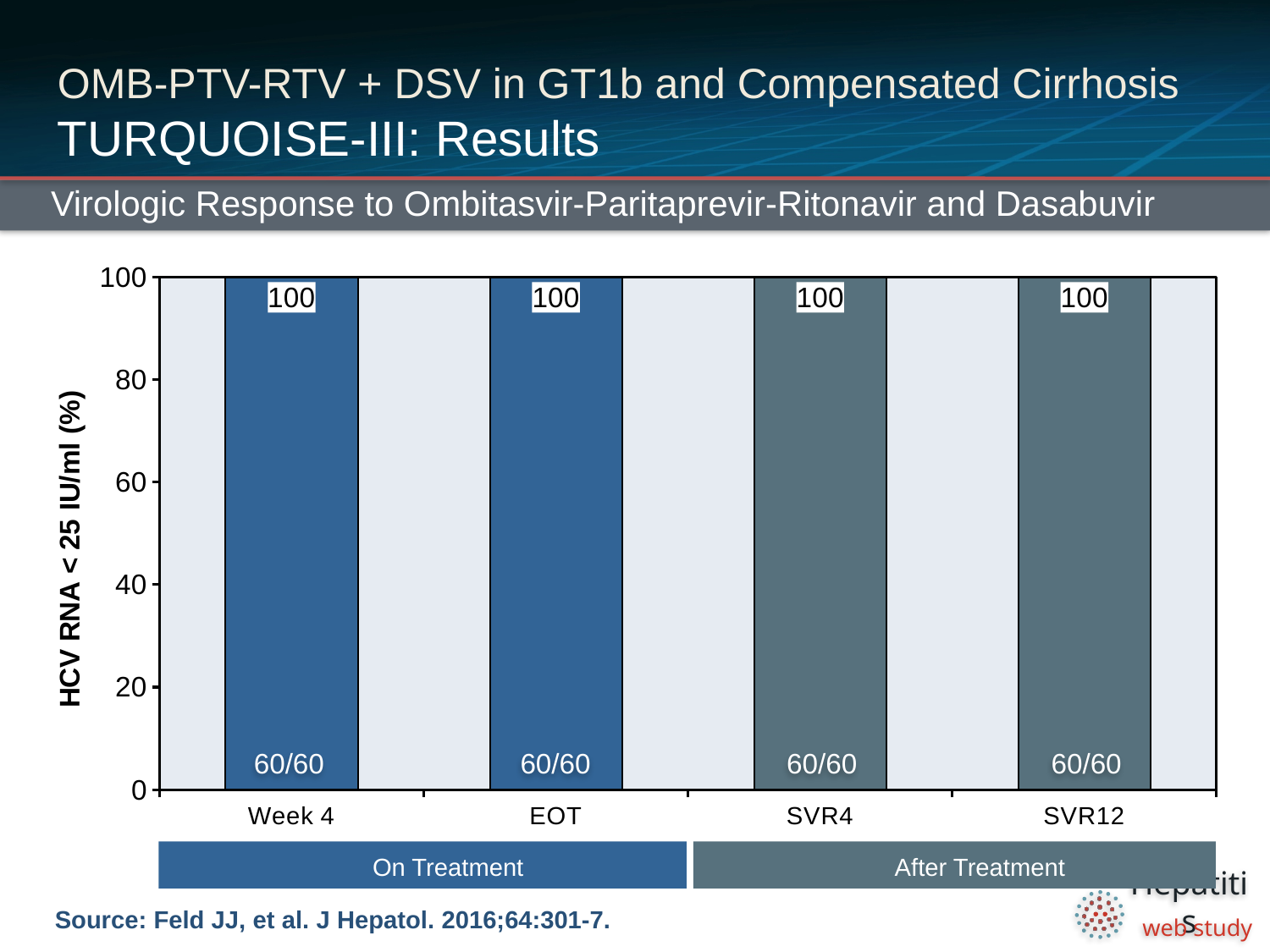
Is the value for SVR4 greater or less than 80? greater What is the value for SVR12? 100 What is the value for Week 4? 100 How many categories are shown on the x axis? 4 Which treatment phase group do the SVR4 and SVR12 bars belong to? After Treatment What fraction of patients is shown inside the SVR4 bar? 60/60 What kind of chart is shown on the slide? Bar chart What fraction of patients is shown inside the EOT bar? 60/60 Do the values rise, fall, or stay the same from Week 4 to SVR12? Stay the same What is the label of the y axis? HCV RNA < 25 IU/ml (%) What is the difference between the values for EOT and SVR12? 0